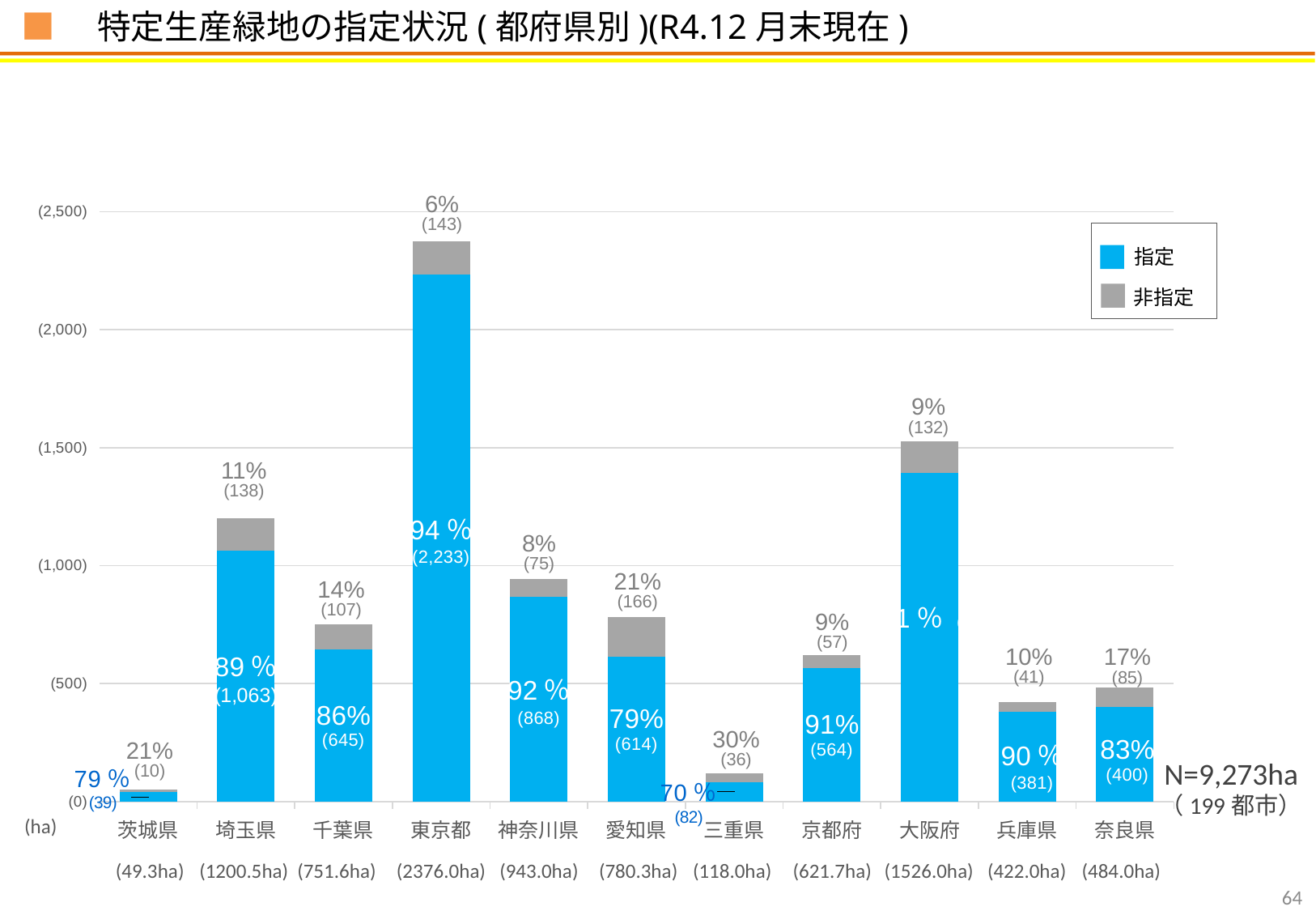
Is the 指定 value for 大阪府 greater or less than 1,000? greater What total area is printed under 兵庫県? 422.0ha What percentage is labelled for 非指定 in 愛知県? 21% How many series does the legend list? 2 What is the difference between the 指定 values of 東京都 and 埼玉県? 1,170 What is the 指定 value (in ha) labelled for 東京都? 2,233 Which prefecture has the highest 指定 value? 東京都 What is the 非指定 value labelled for 三重県? 36 What kind of chart is shown on the slide? stacked bar chart Which prefecture has the lowest total area? 茨城県 Which has the larger 指定 value, 神奈川県 or 千葉県? 神奈川県 How many prefectures are shown on the x axis? 11